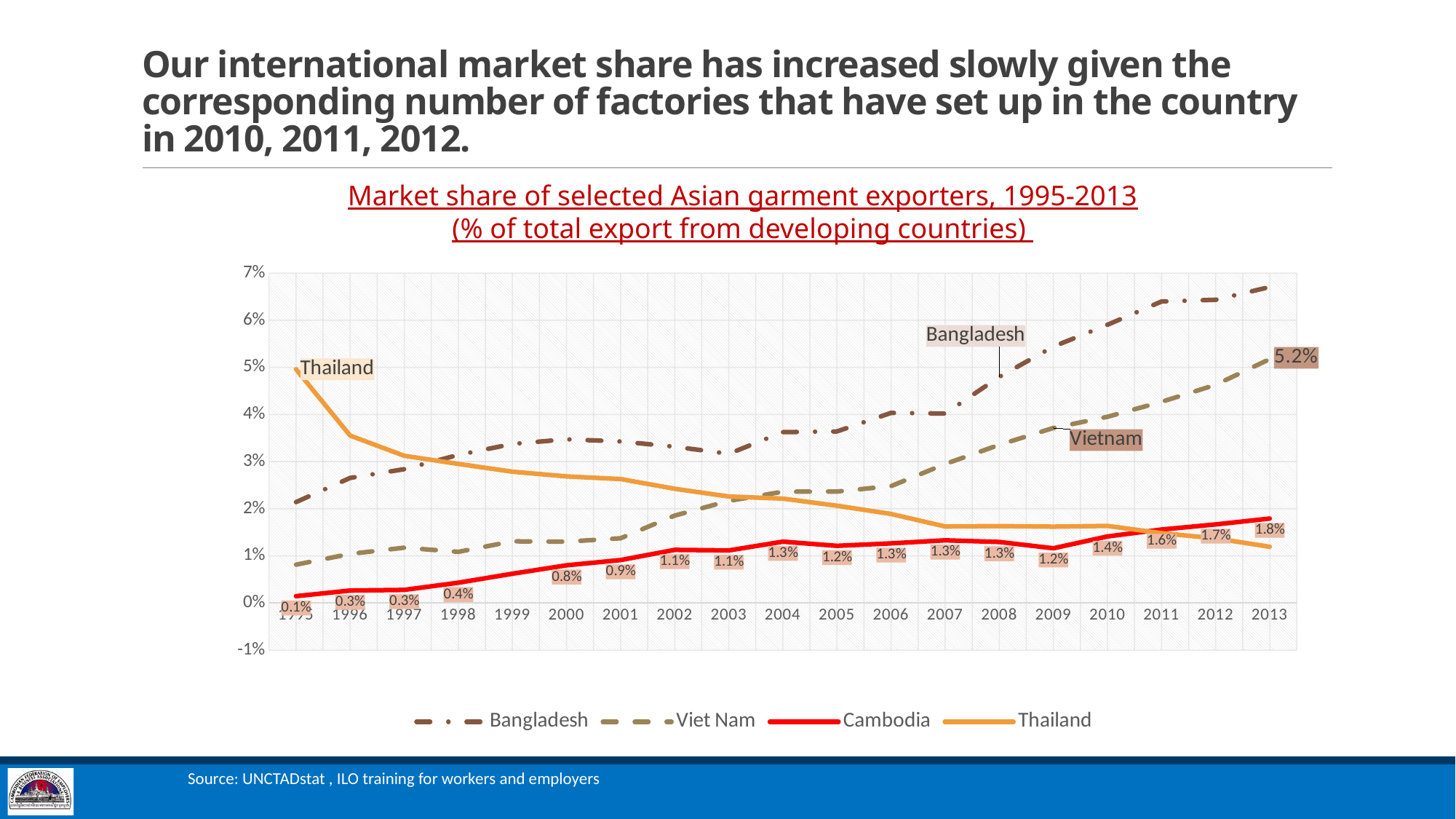
What is Cambodia's market share in 1995? 0.1% What is Viet Nam's market share in 2013? 5.2% What is Cambodia's market share in 2010? 1.4% What kind of chart is shown on the slide? line chart Does Thailand's market share generally rise or fall from 1995 to 2013? fall Is Bangladesh's market share in 2013 greater or less than 6%? greater Which country has the highest market share in 2013? Bangladesh In 2013, which has the larger market share, Viet Nam or Cambodia? Viet Nam What is Cambodia's market share in 2013? 1.8% How many series does the legend list? 4 Does Cambodia's market share generally rise or fall from 1995 to 2013? rise By how many percentage points did Cambodia's market share increase from 1995 to 2013? 1.7 percentage points